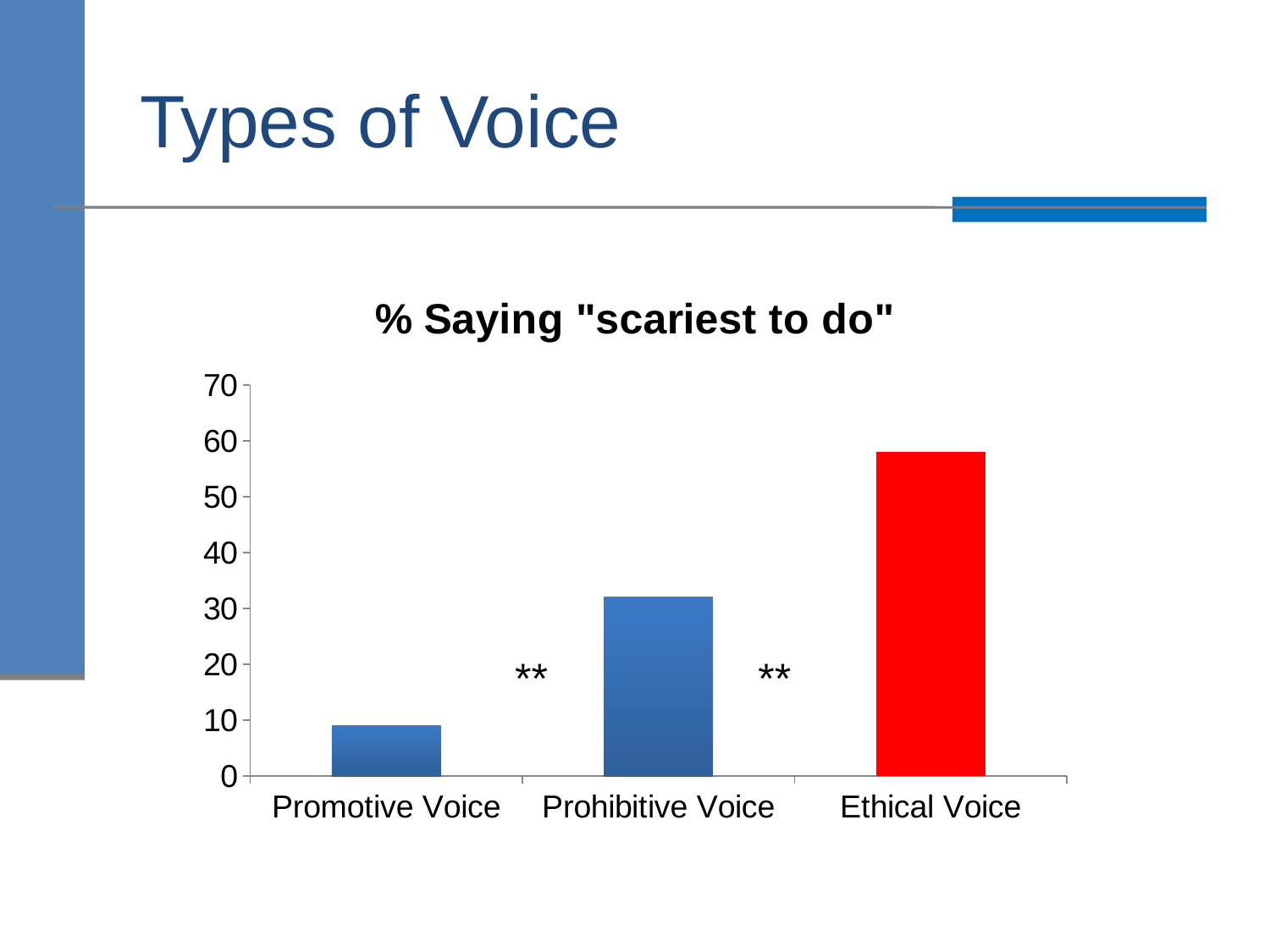
Which is larger, the value for Prohibitive Voice or the value for Promotive Voice? Prohibitive Voice Which category has the lowest value? Promotive Voice Is the value for Ethical Voice greater or less than 50? greater Is the value for Prohibitive Voice greater or less than 30? greater How many categories are shown on the x axis of the chart? 3 What is the title of the chart? % Saying "scariest to do" Is the value for Prohibitive Voice greater or less than 40? less Do the values rise or fall moving from left to right along the x axis? rise Which category has the highest value? Ethical Voice Which bar is coloured red? Ethical Voice What kind of chart is shown on the slide? bar chart